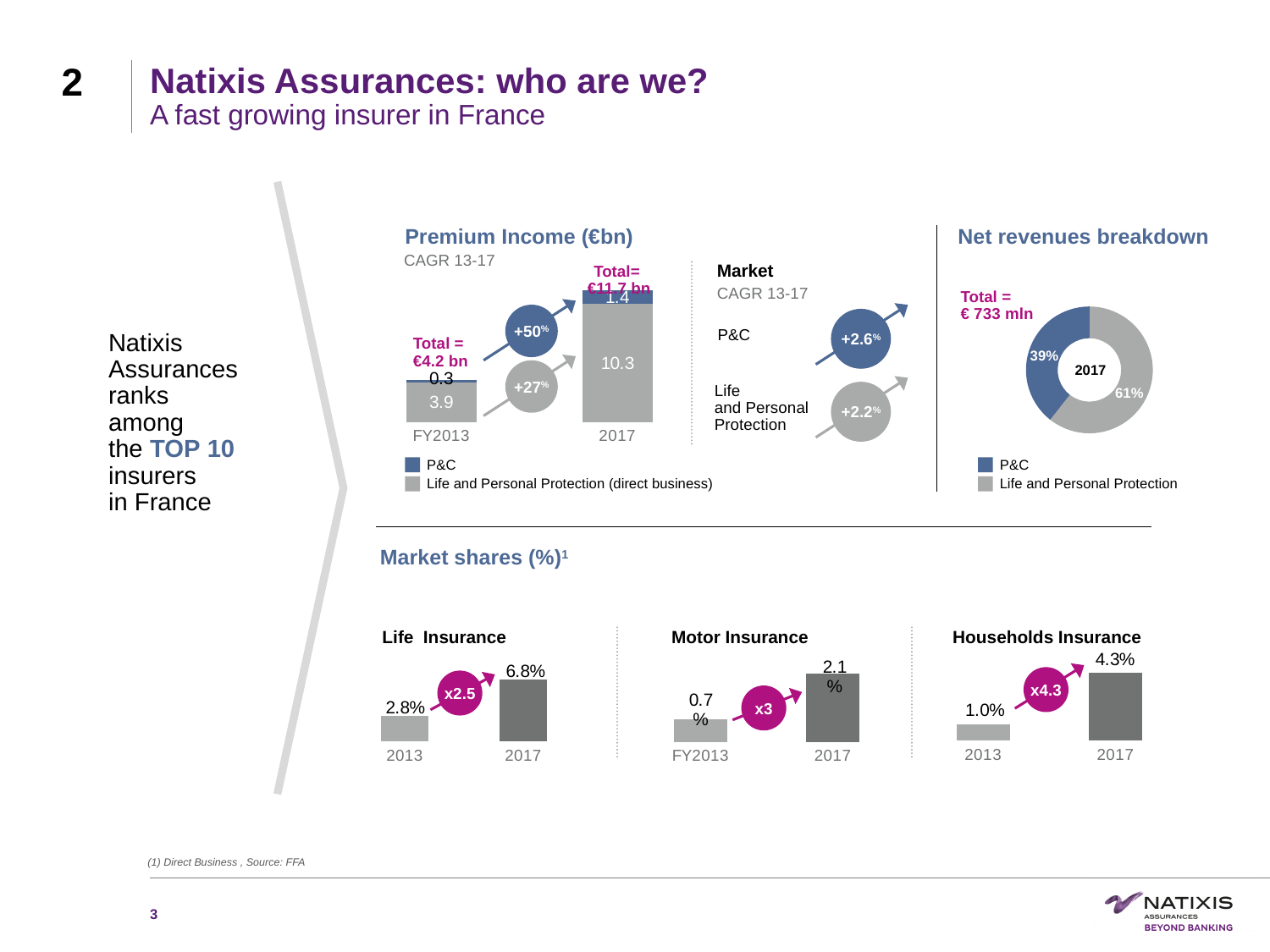
In the Motor Insurance market shares chart, what is the value for FY2013? 0.7% In the Households Insurance market shares chart, what is the difference between the 2017 and 2013 values? 3.3% In the Households Insurance market shares chart, do the values rise or fall from 2013 to 2017? Rise What kind of chart is the Net revenues breakdown chart? Donut (pie) chart In the Premium Income (€bn) chart, what is the total of the 2017 stacked bar? €11.7 bn In the Premium Income (€bn) chart, what is the difference between the Life and Personal Protection values for 2017 and FY2013? 6.4 In the Net revenues breakdown chart, which segment is larger, P&C or Life and Personal Protection? Life and Personal Protection In the Net revenues breakdown chart, what share does P&C represent? 39% In the Premium Income (€bn) chart, how many series does the legend list? 2 In the Premium Income (€bn) chart, what is the value for P&C in FY2013? 0.3 In the Life Insurance market shares chart, what is the value for 2017? 6.8% In the Premium Income (€bn) chart, what is the value for Life and Personal Protection (direct business) in 2017? 10.3